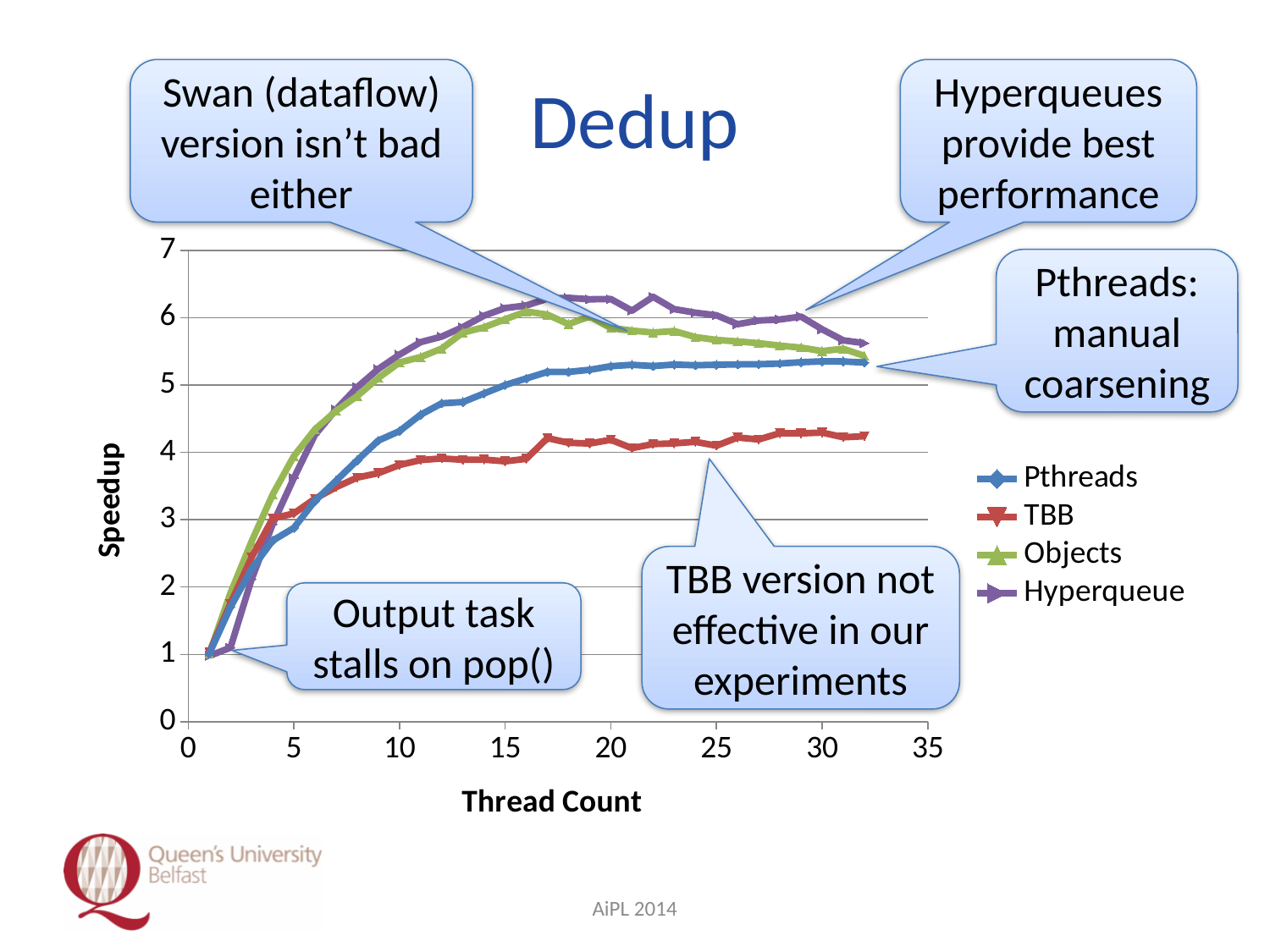
What kind of chart is shown on the slide? line chart Which series reaches the highest peak speedup? Hyperqueue At 20 threads, which has the larger speedup, Objects or Pthreads? Objects Is the speedup for TBB at 32 threads greater or less than 4? greater How many series does the legend list? 4 Which series has the lowest speedup at 32 threads? TBB At 32 threads, which has the larger speedup, Hyperqueue or TBB? Hyperqueue Is the speedup for Hyperqueue at 20 threads greater or less than 6? greater Is the speedup for TBB at 10 threads greater or less than 4? less What is the title of the chart? Dedup Does the Hyperqueue speedup rise or fall between 20 and 32 threads? fall What is the label on the y axis? Speedup